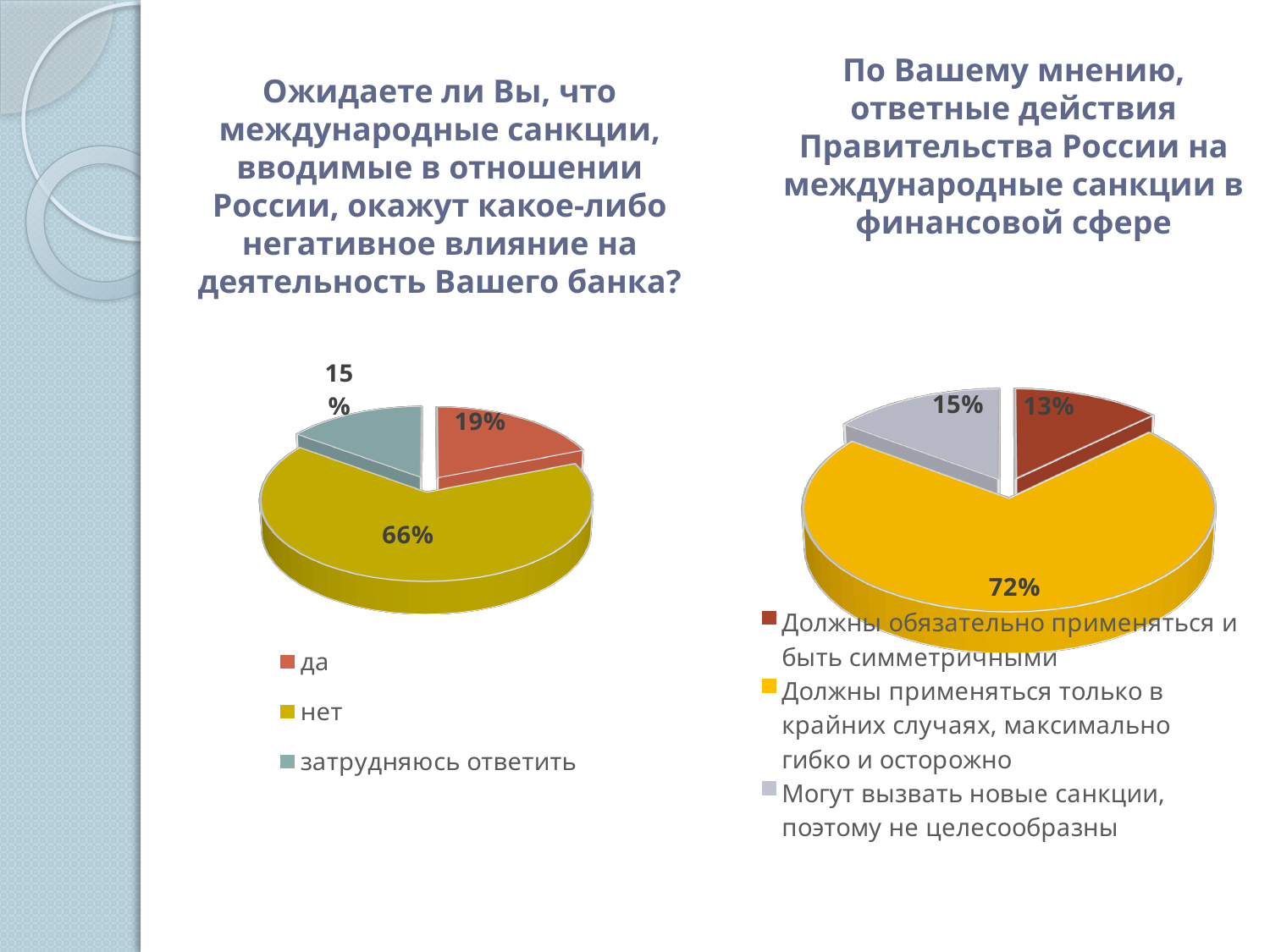
In the right pie chart, which is larger: the share for "Могут вызвать новые санкции, поэтому не целесообразны" or the share for "Должны обязательно применяться и быть симметричными"? Могут вызвать новые санкции, поэтому не целесообразны In the left pie chart, what share of respondents answered "да"? 19% In the left pie chart, what share of respondents answered "нет"? 66% In the right pie chart, what share of respondents chose "Должны обязательно применяться и быть симметричными"? 13% In the left pie chart, which answer has the smallest share? затрудняюсь ответить How many slices does the left pie chart have? 3 In the right pie chart, which option has the smallest share? Должны обязательно применяться и быть симметричными In the left pie chart, which answer has the largest share? нет What type of chart is used on the right side of the slide? Pie chart In the right pie chart, what share of respondents chose "Должны применяться только в крайних случаях, максимально гибко и осторожно"? 72% In the left pie chart, what is the difference between the shares for "нет" and "да"? 47 percentage points In the left pie chart, what share of respondents answered "затрудняюсь ответить"? 15%